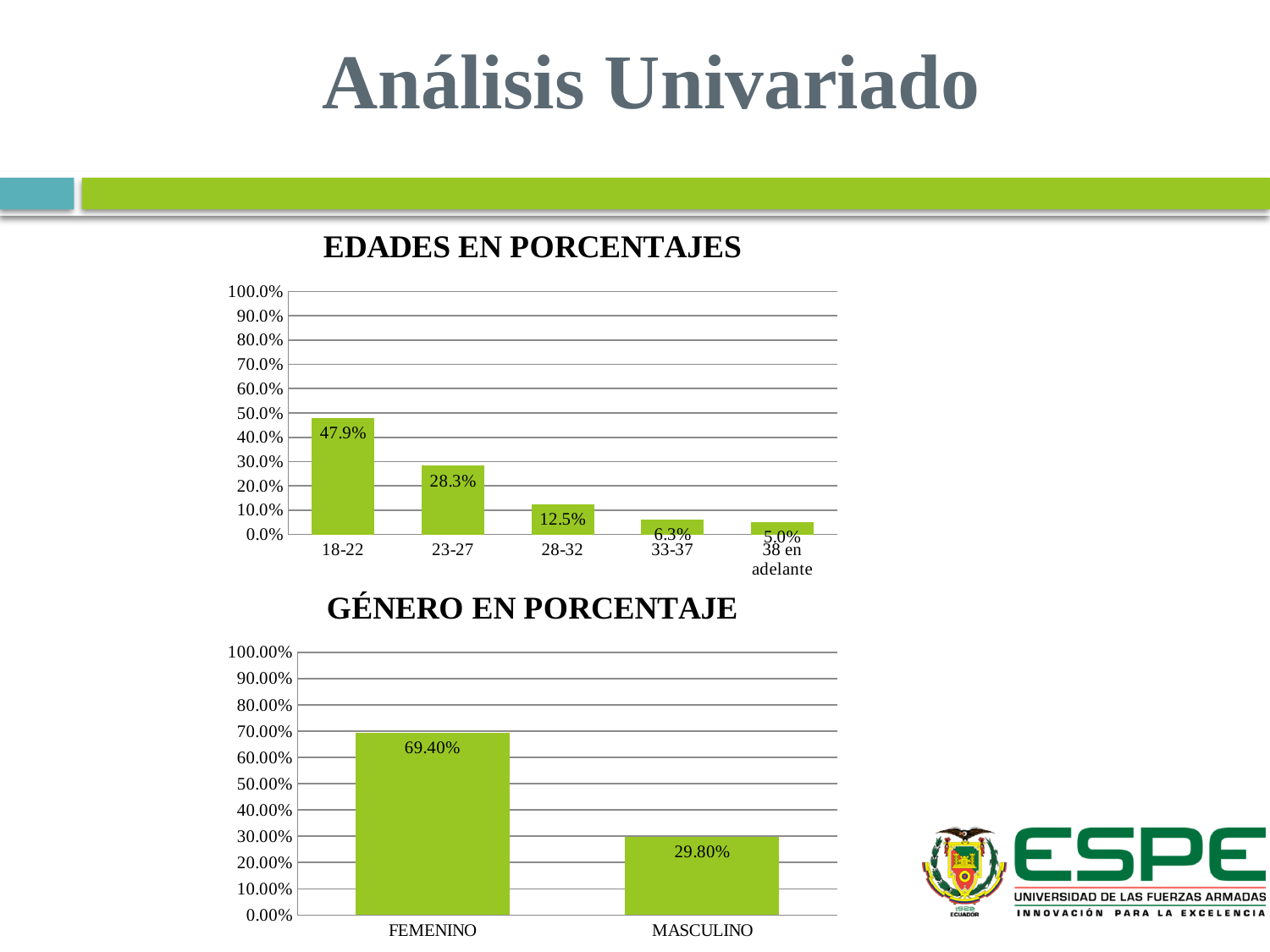
In the 'EDADES EN PORCENTAJES' chart, what is the value for the 18-22 age group? 47.9% In the 'EDADES EN PORCENTAJES' chart, do the values rise or fall from left to right along the x axis? fall In the 'EDADES EN PORCENTAJES' chart, what is the difference between the 18-22 and 23-27 values? 19.6% In the 'EDADES EN PORCENTAJES' chart, which age group has the lowest percentage? 38 en adelante In the 'GÉNERO EN PORCENTAJE' chart, what is the difference between the FEMENINO and MASCULINO values? 39.60% What type of chart is the 'GÉNERO EN PORCENTAJE' chart? bar chart In the 'GÉNERO EN PORCENTAJE' chart, what is the value for FEMENINO? 69.40% In the 'GÉNERO EN PORCENTAJE' chart, what is the value for MASCULINO? 29.80% In the 'EDADES EN PORCENTAJES' chart, which age group has the highest percentage? 18-22 In the 'EDADES EN PORCENTAJES' chart, how many age groups are shown? 5 In the 'EDADES EN PORCENTAJES' chart, what is the value for the 28-32 age group? 12.5% In the 'GÉNERO EN PORCENTAJE' chart, which category is larger, FEMENINO or MASCULINO? FEMENINO